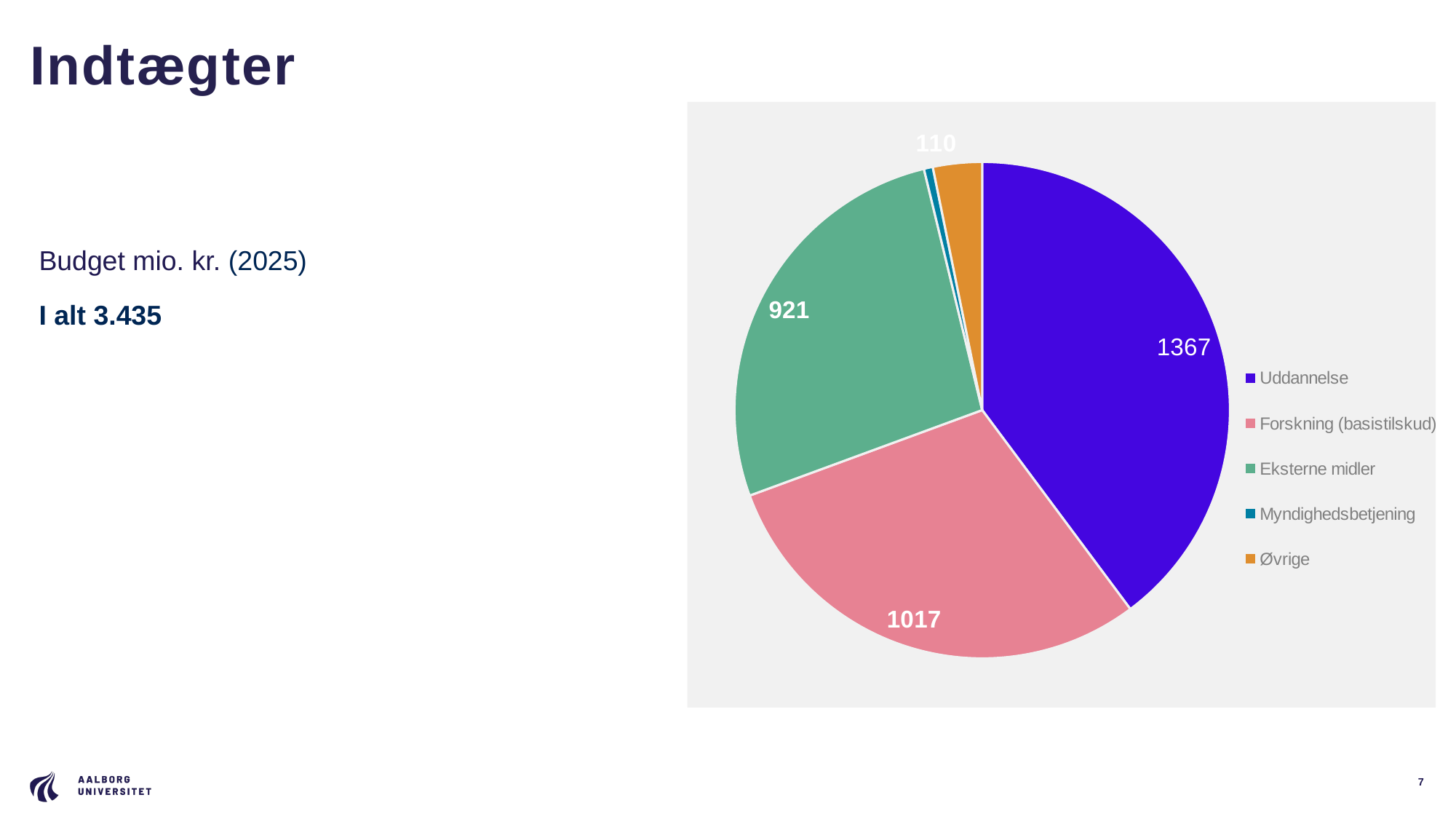
What is the value for Uddannelse? 1367 Which category has the smallest slice of the pie? Myndighedsbetjening What kind of chart is shown on the slide? pie chart Which category has the largest slice of the pie? Uddannelse What is the value for Eksterne midler? 921 What total (I alt) is stated on the slide for the budget? 3.435 Which is larger, Eksterne midler or Øvrige? Eksterne midler What is the value for Forskning (basistilskud)? 1017 How many categories does the pie chart have? 5 What is the difference between the values for Forskning (basistilskud) and Eksterne midler? 96 What is the value for Øvrige? 110 What is the difference between the values for Uddannelse and Forskning (basistilskud)? 350